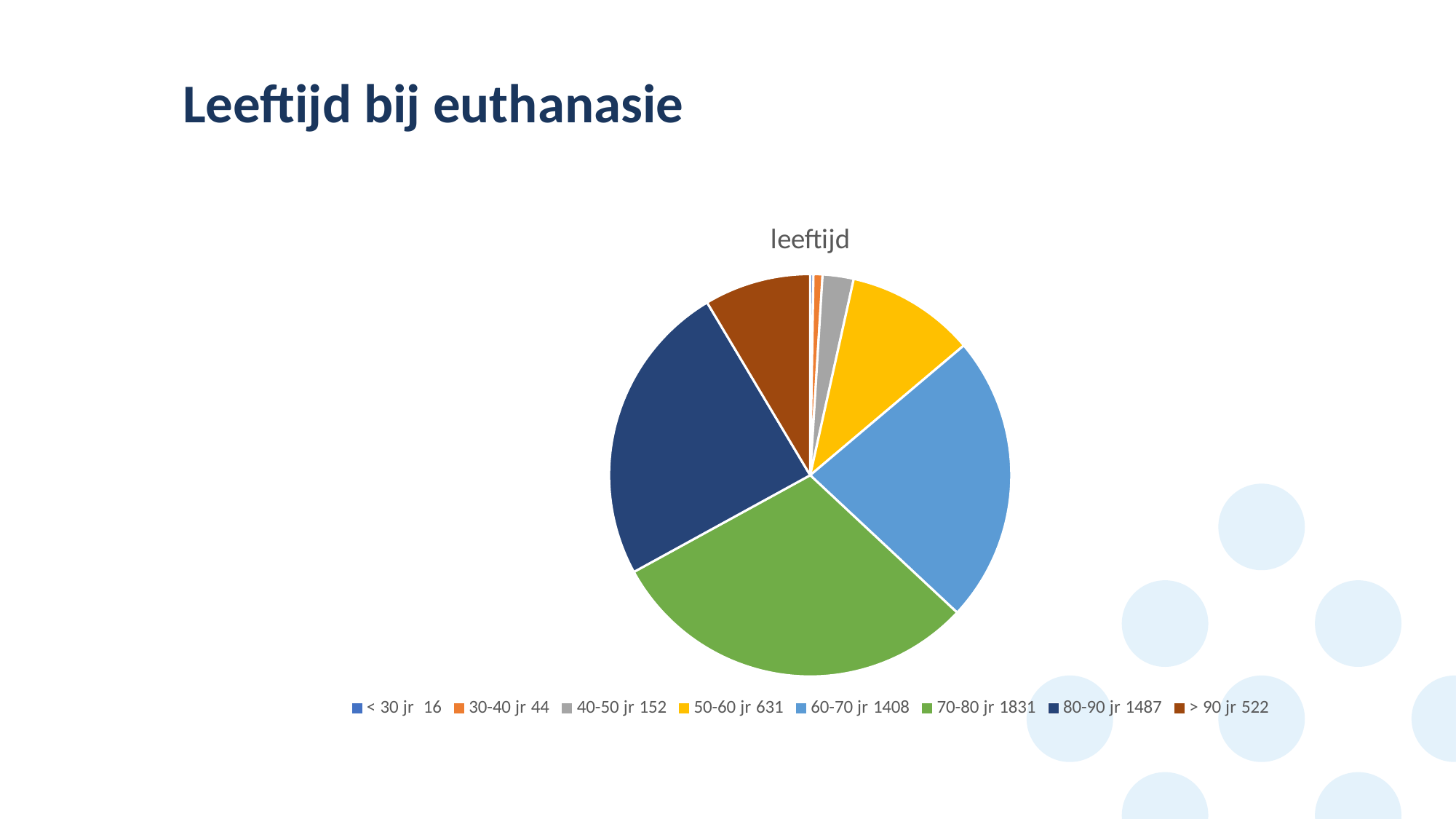
What is the difference between the values for 60-70 jr and 50-60 jr? 777 What is the value for the 50-60 jr category? 631 What kind of chart is shown on the slide? pie chart What is the value for the 70-80 jr category? 1831 What is the difference between the values for 70-80 jr and 80-90 jr? 344 Which age category has the highest value? 70-80 jr What is the title of the chart? leeftijd How many age categories does the pie chart show? 8 Which age category has the lowest value? < 30 jr What colour is the slice for the 70-80 jr category? green What is the value for the > 90 jr category? 522 Which is larger, the value for 80-90 jr or the value for 60-70 jr? 80-90 jr